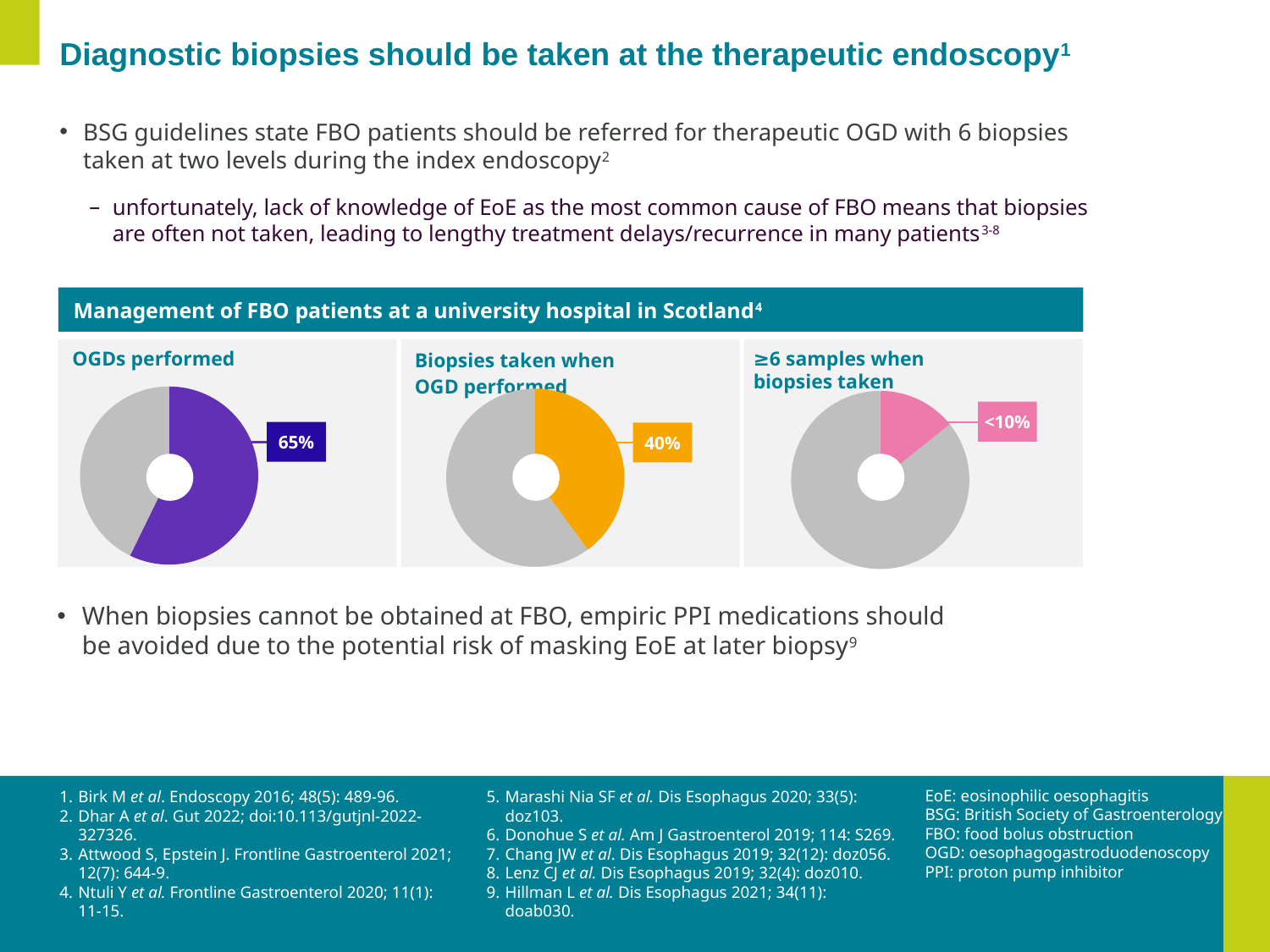
In the 'OGDs performed' chart, what percentage is shown for the highlighted slice? 65% How many charts are shown in the 'Management of FBO patients at a university hospital in Scotland' panel? 3 In the '≥6 samples when biopsies taken' chart, what value is labelled on the highlighted slice? <10% What is the title of the panel containing the three charts? Management of FBO patients at a university hospital in Scotland What colour is the highlighted slice in the 'OGDs performed' chart? purple In the 'Biopsies taken when OGD performed' chart, what percentage is shown for the highlighted slice? 40% Is the highlighted share larger in the 'OGDs performed' chart or in the 'Biopsies taken when OGD performed' chart? OGDs performed Is the highlighted share in the 'Biopsies taken when OGD performed' chart greater or less than 50%? less What kind of chart is used in the 'Management of FBO patients at a university hospital in Scotland' panel? pie chart What is the difference between the highlighted share in the 'OGDs performed' chart and the highlighted share in the 'Biopsies taken when OGD performed' chart? 25% Which chart shows the smallest highlighted share: 'OGDs performed', 'Biopsies taken when OGD performed', or '≥6 samples when biopsies taken'? ≥6 samples when biopsies taken Which chart shows the largest highlighted share: 'OGDs performed', 'Biopsies taken when OGD performed', or '≥6 samples when biopsies taken'? OGDs performed